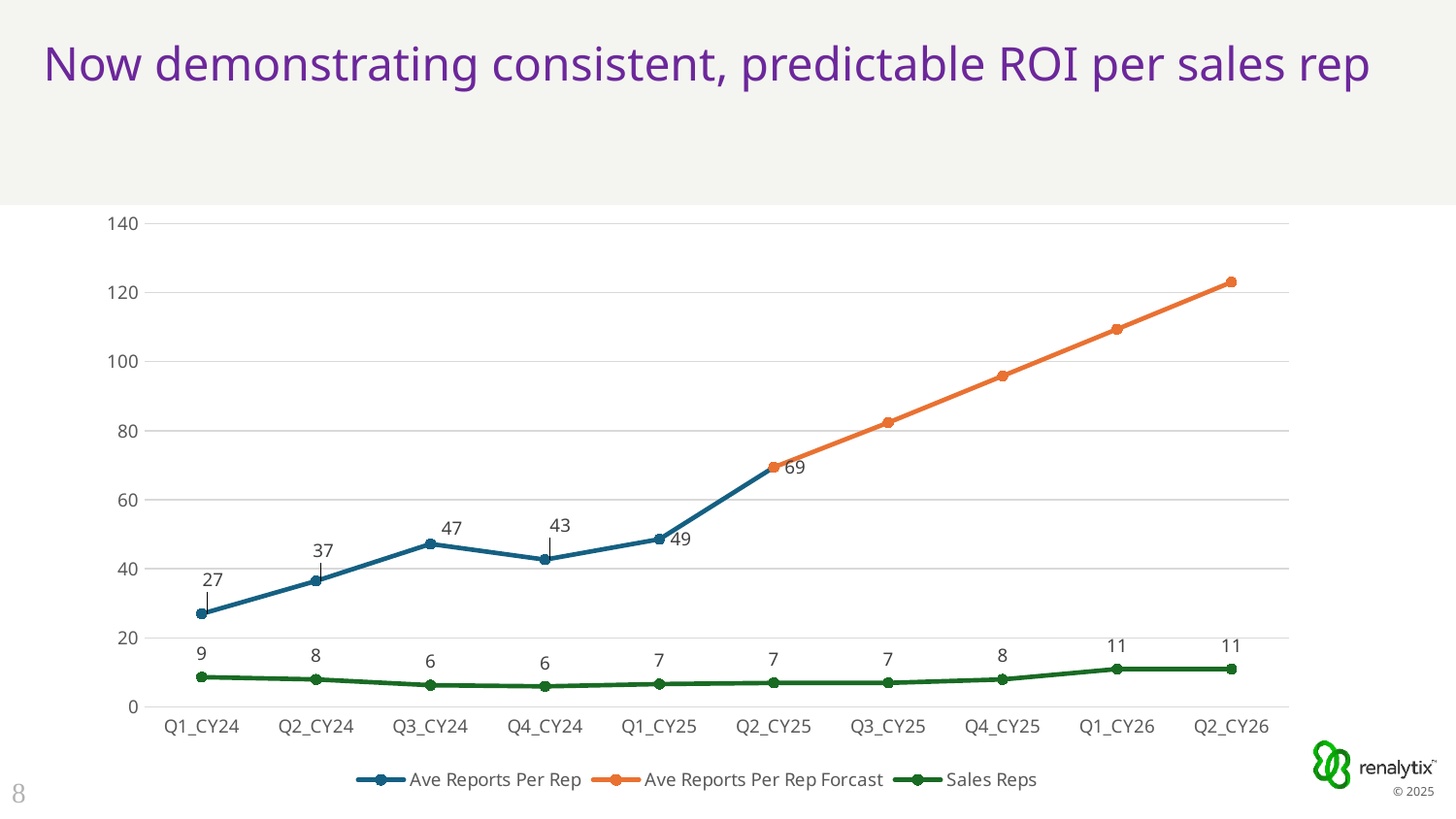
How many Sales Reps are shown for Q1_CY26? 11 How many quarters are shown on the x axis? 10 How many series does the legend list? 3 Is the Ave Reports Per Rep Forcast value for Q2_CY26 greater or less than 120? greater What is the value of Ave Reports Per Rep in Q2_CY25? 69 Which is larger, Ave Reports Per Rep in Q2_CY24 or in Q1_CY25? Q1_CY25 In which quarter is the Sales Reps value lowest? Q3_CY24 and Q4_CY24 Does the Ave Reports Per Rep Forcast line rise or fall from Q2_CY25 to Q2_CY26? rise What is the value of Ave Reports Per Rep in Q1_CY24? 27 Which quarter has the highest labelled value for Ave Reports Per Rep? Q2_CY25 What kind of chart is shown on the slide? line chart What is the difference between Ave Reports Per Rep in Q3_CY24 and Q4_CY24? 4